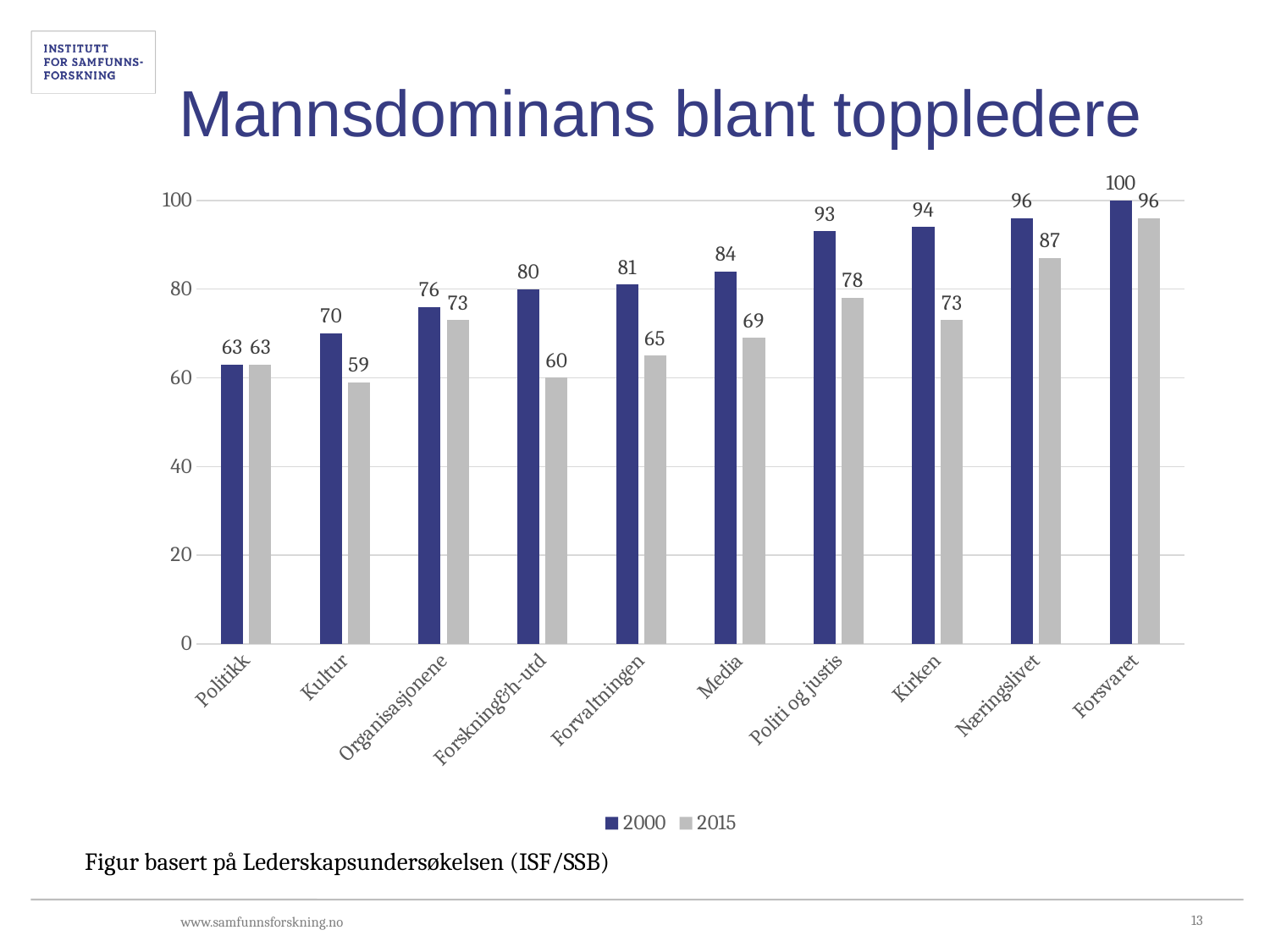
What is the difference between the 2000 and 2015 values for Forskning&h-utd? 20 What kind of chart is shown on the slide? Bar chart What is the value for Forskning&h-utd in the 2015 series? 60 How many series does the legend list? 2 Which category has the lowest value in the 2015 series? Kultur How many categories are shown on the x axis? 10 What is the value for Media in the 2000 series? 84 Which category has the highest value in the 2000 series? Forsvaret What is the title of the chart? Mannsdominans blant toppledere What is the difference between the 2000 and 2015 values for Kirken? 21 What is the value for Kirken in the 2015 series? 73 Which is larger: the 2015 value for Næringslivet or the 2015 value for Politi og justis? Næringslivet